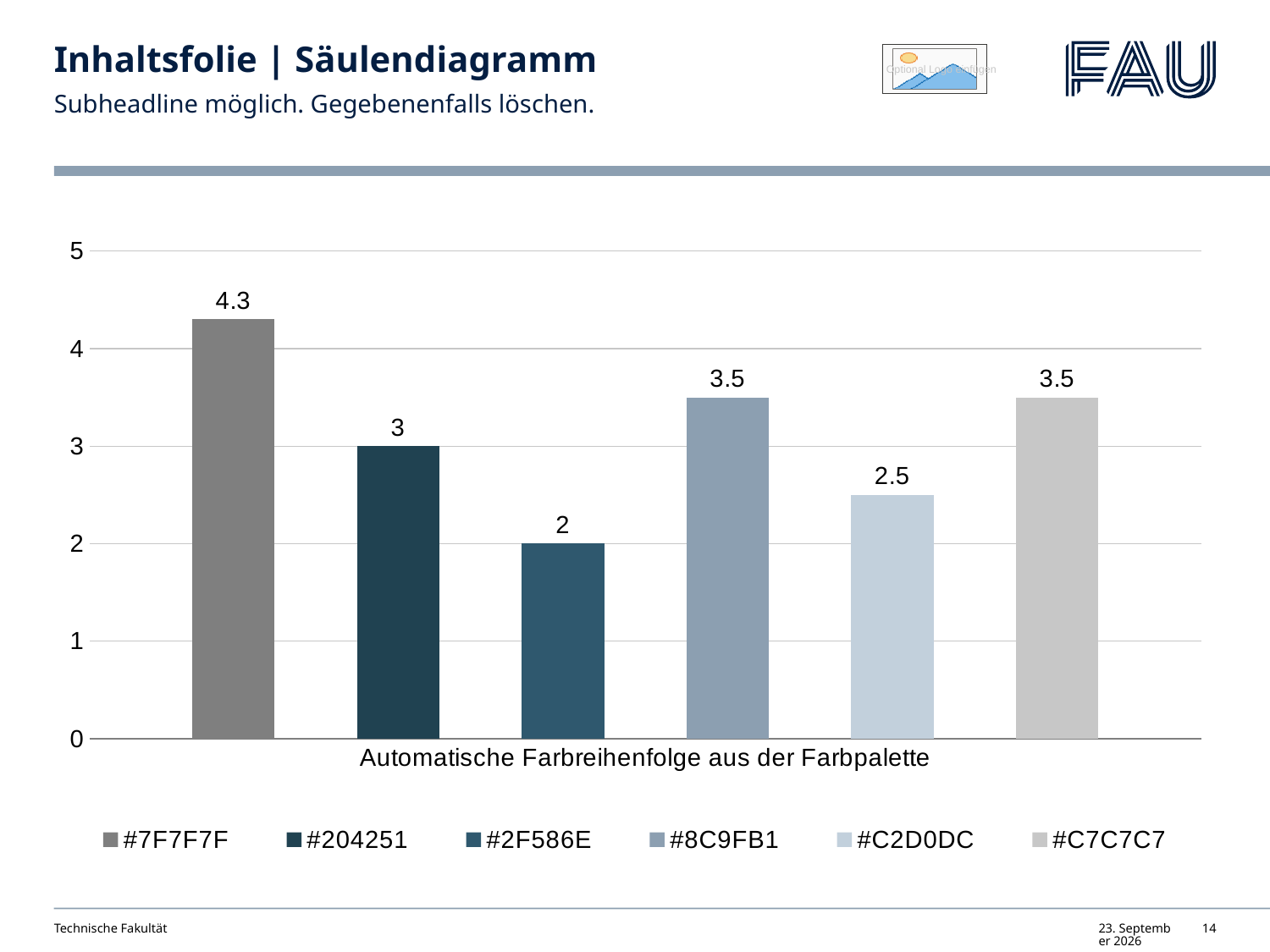
How many series does the legend list? 6 What is the difference between the values for #7F7F7F and #204251? 1.3 What is the value for the series #C2D0DC? 2.5 What is the category label shown on the x axis? Automatische Farbreihenfolge aus der Farbpalette What kind of chart is shown on the slide? Bar chart What is the value for the series #2F586E? 2 Which series has the highest value? #7F7F7F What is the value for the series #7F7F7F? 4.3 What is the value for the series #204251? 3 Which series has the lowest value? #2F586E Which is larger, the value for #8C9FB1 or the value for #C2D0DC? #8C9FB1 What is the difference between the values for #C7C7C7 and #2F586E? 1.5